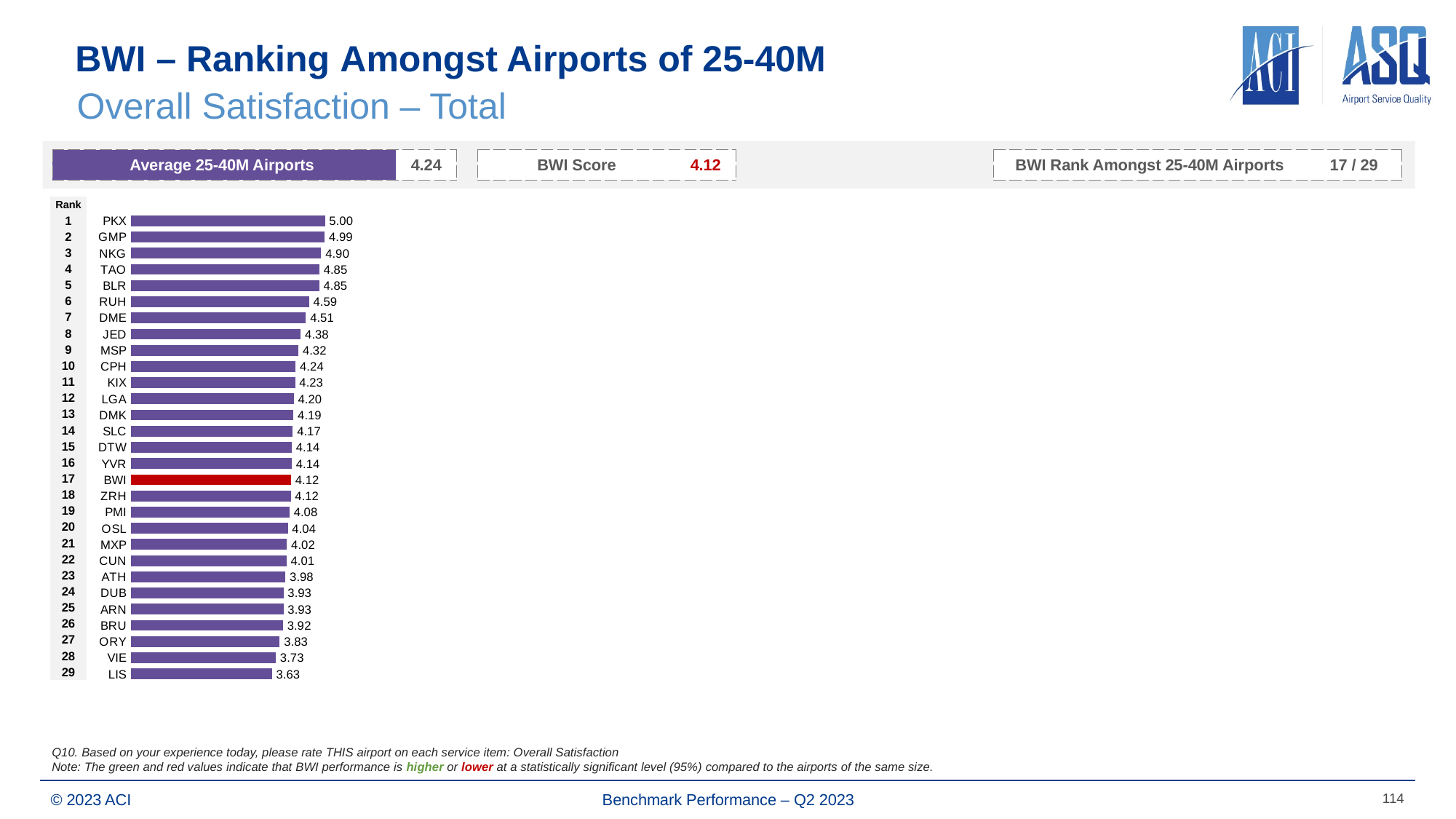
What is the difference between the values for PKX and LIS? 1.37 What is the value for BWI? 4.12 Which bar is coloured red in the chart? BWI Which airport has the highest value? PKX What kind of chart is shown on the slide? Bar chart What is BWI's rank amongst 25-40M airports? 17 / 29 What is the value for LIS? 3.63 How many airports are ranked in the chart? 29 Which is larger, the value for RUH or the value for MSP? RUH What is the difference between the values for BWI and the Average 25-40M Airports? 0.12 Which airport has the lowest value? LIS What is the value for PKX? 5.00